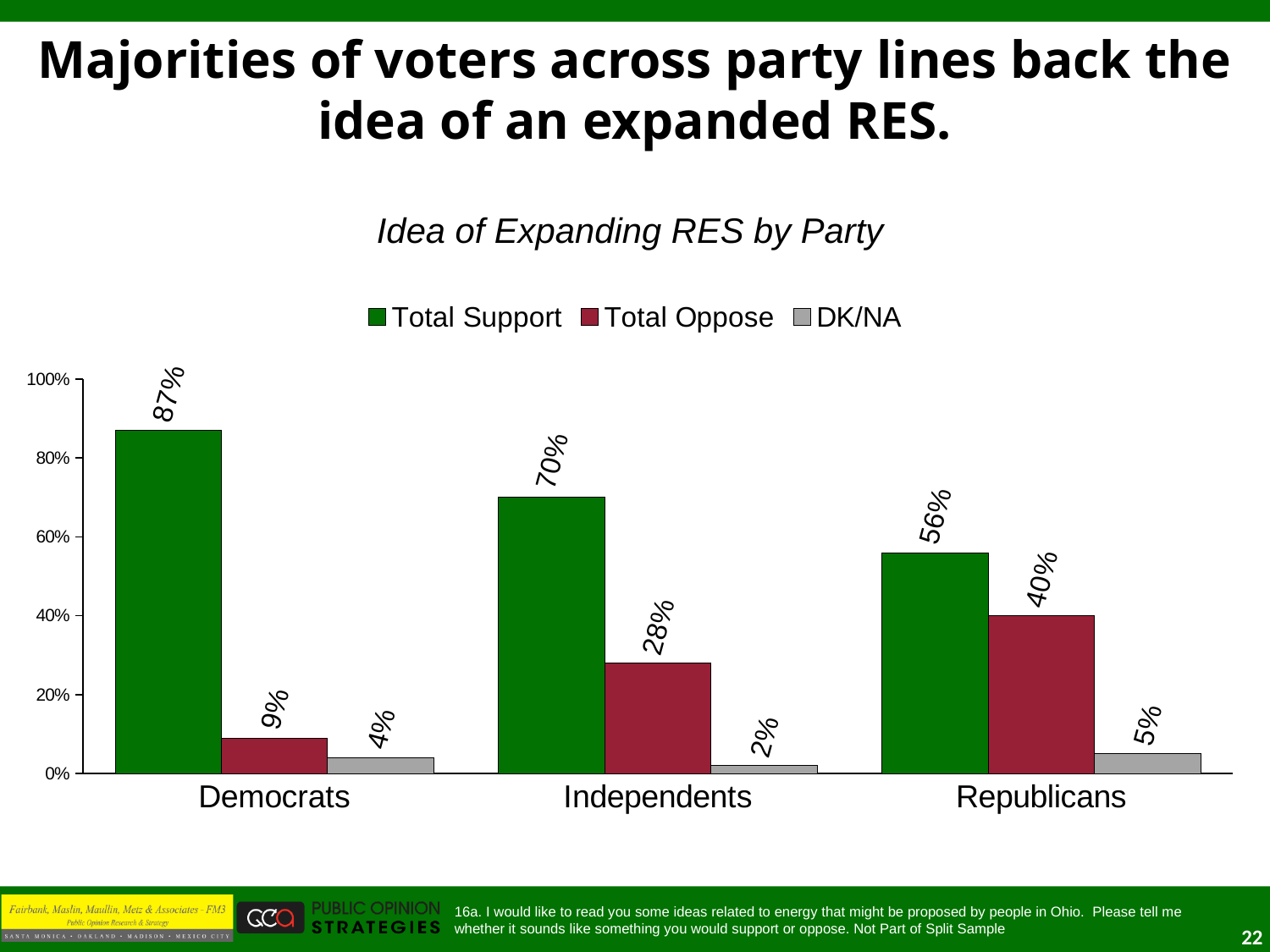
What is the title of the chart? Idea of Expanding RES by Party Is the Total Support value for Independents greater or less than 60%? greater Which party has the highest Total Support value? Democrats How many series does the legend list? 3 How many party categories are shown on the x axis? 3 What is the Total Oppose value for Republicans? 40% Which is larger for Independents: Total Support or Total Oppose? Total Support Which party has the lowest Total Oppose value? Democrats What is the difference between Total Support and Total Oppose for Republicans? 16% What is the Total Support value for Democrats? 87% What kind of chart is shown on the slide? Bar chart What is the DK/NA value for Independents? 2%